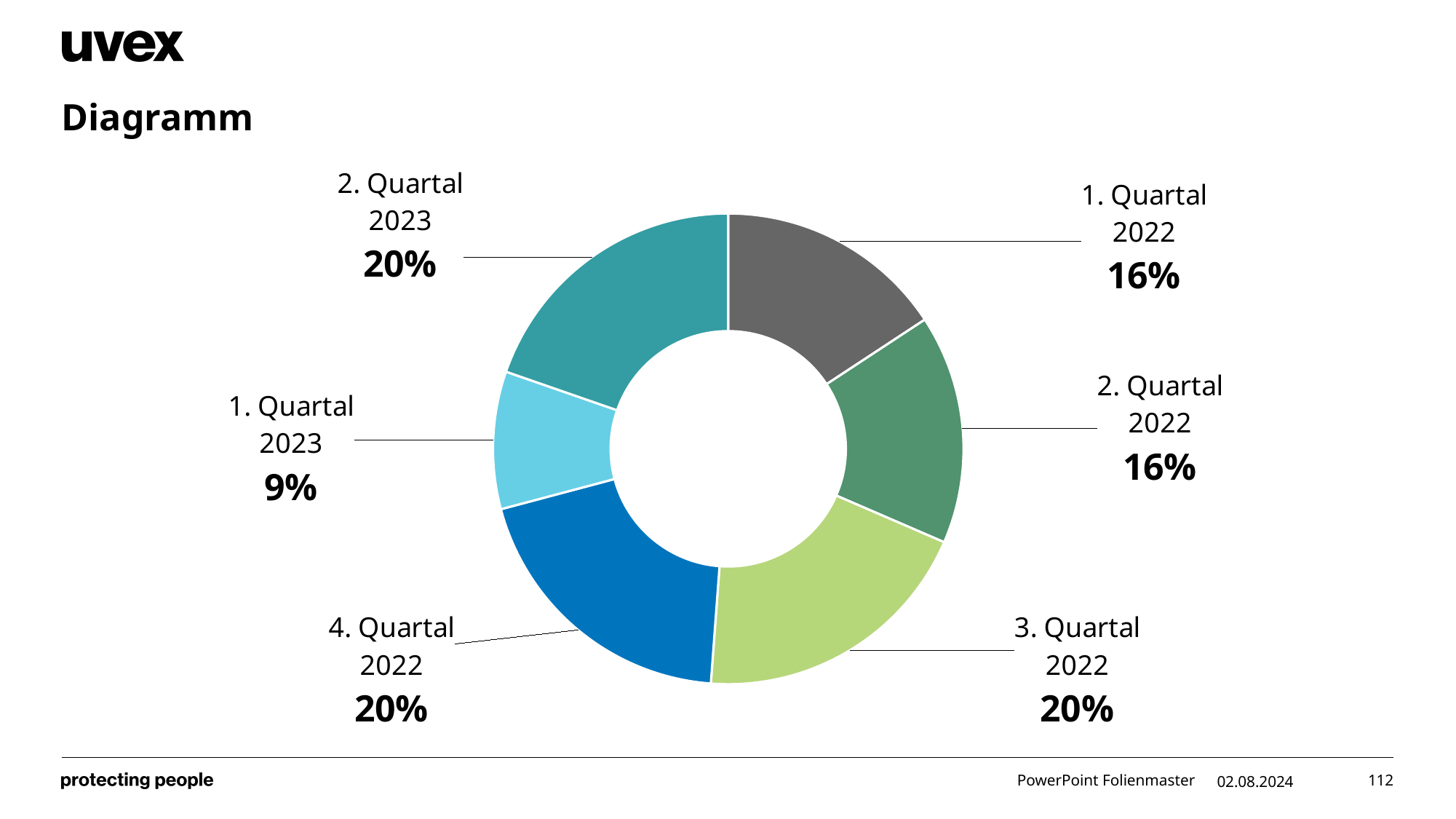
Which is larger, the slice for 2. Quartal 2022 or the slice for 3. Quartal 2022? 3. Quartal 2022 What share does 1. Quartal 2023 have in the chart? 9% What percentage is shown for 1. Quartal 2022? 16% What is the value shown for 3. Quartal 2022? 20% What is the title of the slide containing the chart? Diagramm Which category has the smallest slice in the chart? 1. Quartal 2023 What kind of chart is shown on the slide? Doughnut (pie) chart How many slices does the chart have? 6 By how many percentage points does 2. Quartal 2023 exceed 1. Quartal 2023? 11 percentage points What is the value for 2. Quartal 2023? 20% What is the difference between the values for 4. Quartal 2022 and 1. Quartal 2022? 4 percentage points Which is larger, the slice for 4. Quartal 2022 or the slice for 1. Quartal 2023? 4. Quartal 2022